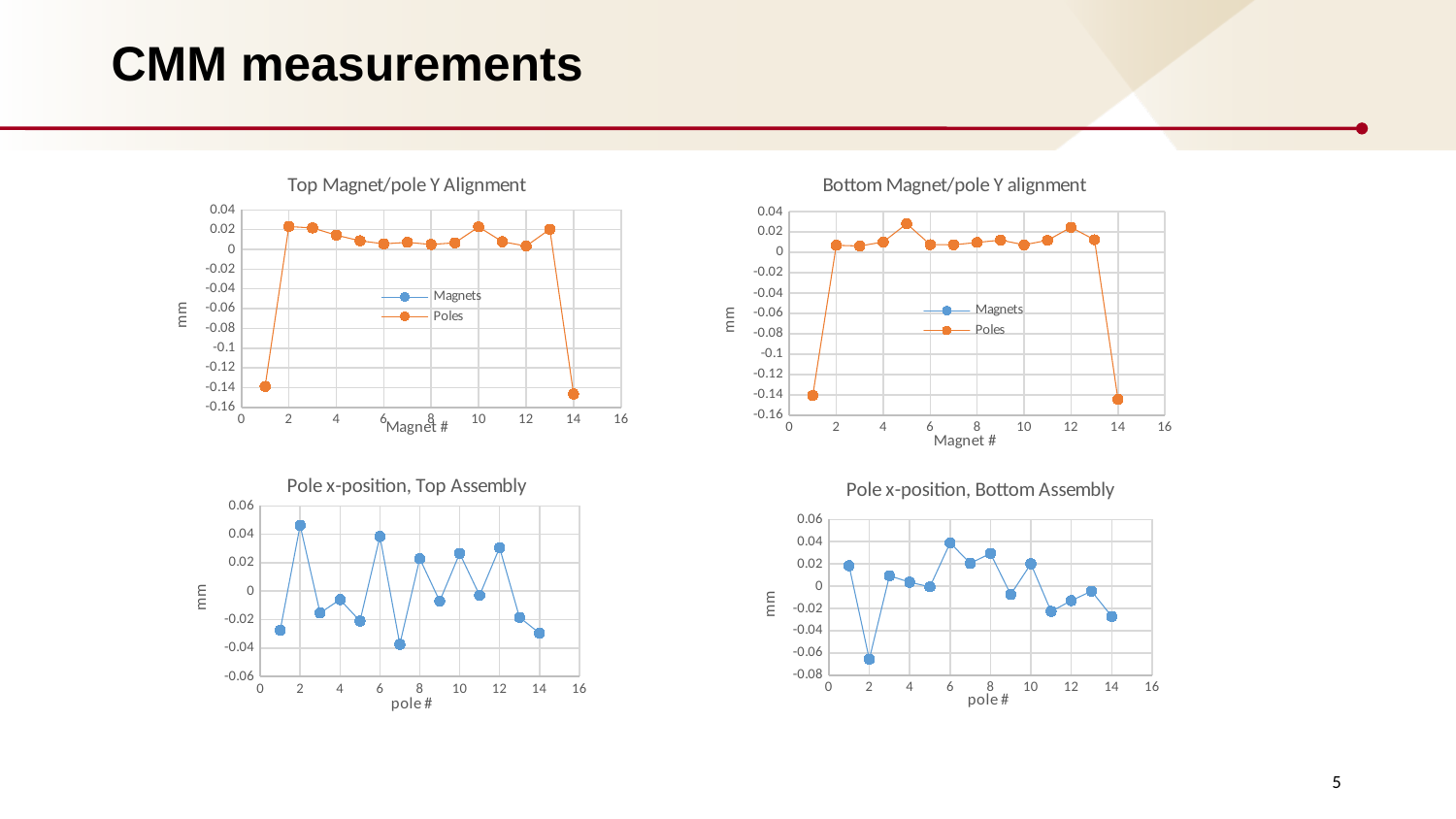
In the 'Top Magnet/pole Y Alignment' chart, how many series does the legend list? 2 In the 'Bottom Magnet/pole Y alignment' chart, is the value at magnet 14 greater or less than -0.1? less In the 'Top Magnet/pole Y Alignment' chart, is the value at magnet 1 greater or less than -0.1? less In the 'Top Magnet/pole Y Alignment' chart, what are the names of the two series in the legend? Magnets and Poles In the 'Pole x-position, Top Assembly' chart, which pole number has the lowest value? 7 What kind of chart is 'Pole x-position, Bottom Assembly'? line chart In the 'Pole x-position, Bottom Assembly' chart, how many data points are plotted? 14 In the 'Pole x-position, Top Assembly' chart, which pole number has the highest value? 2 In the 'Pole x-position, Bottom Assembly' chart, which pole number has the lowest value? 2 In the 'Pole x-position, Bottom Assembly' chart, which pole number has the highest value? 6 In the 'Bottom Magnet/pole Y alignment' chart, is the value at magnet 5 greater or less than 0.02? greater